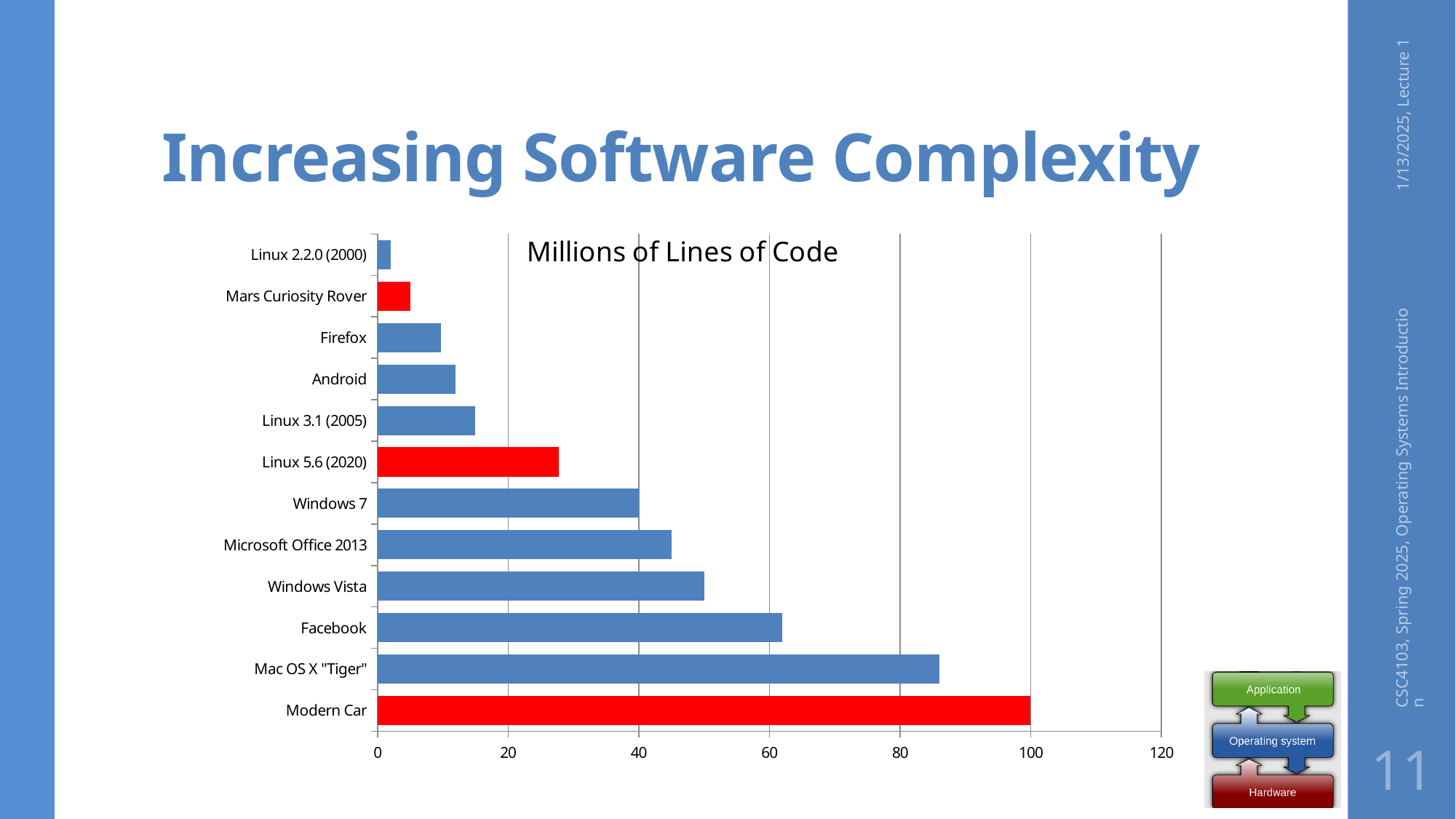
Which category has the lowest value? Linux 2.2.0 (2000) Is the value for Linux 5.6 (2020) greater or less than 20? greater What is the value for Modern Car? 100 Which categories are drawn with red bars? Mars Curiosity Rover, Linux 5.6 (2020), Modern Car What kind of chart is shown on the slide? bar chart What is the value for Windows 7? 40 Is the value for Facebook greater or less than 60? greater Is the value for Mac OS X "Tiger" greater or less than 80? greater Which is larger, the value for Windows Vista or the value for Microsoft Office 2013? Windows Vista Which category has the highest value? Modern Car How many categories are plotted in the chart? 12 What is the title of the chart? Millions of Lines of Code